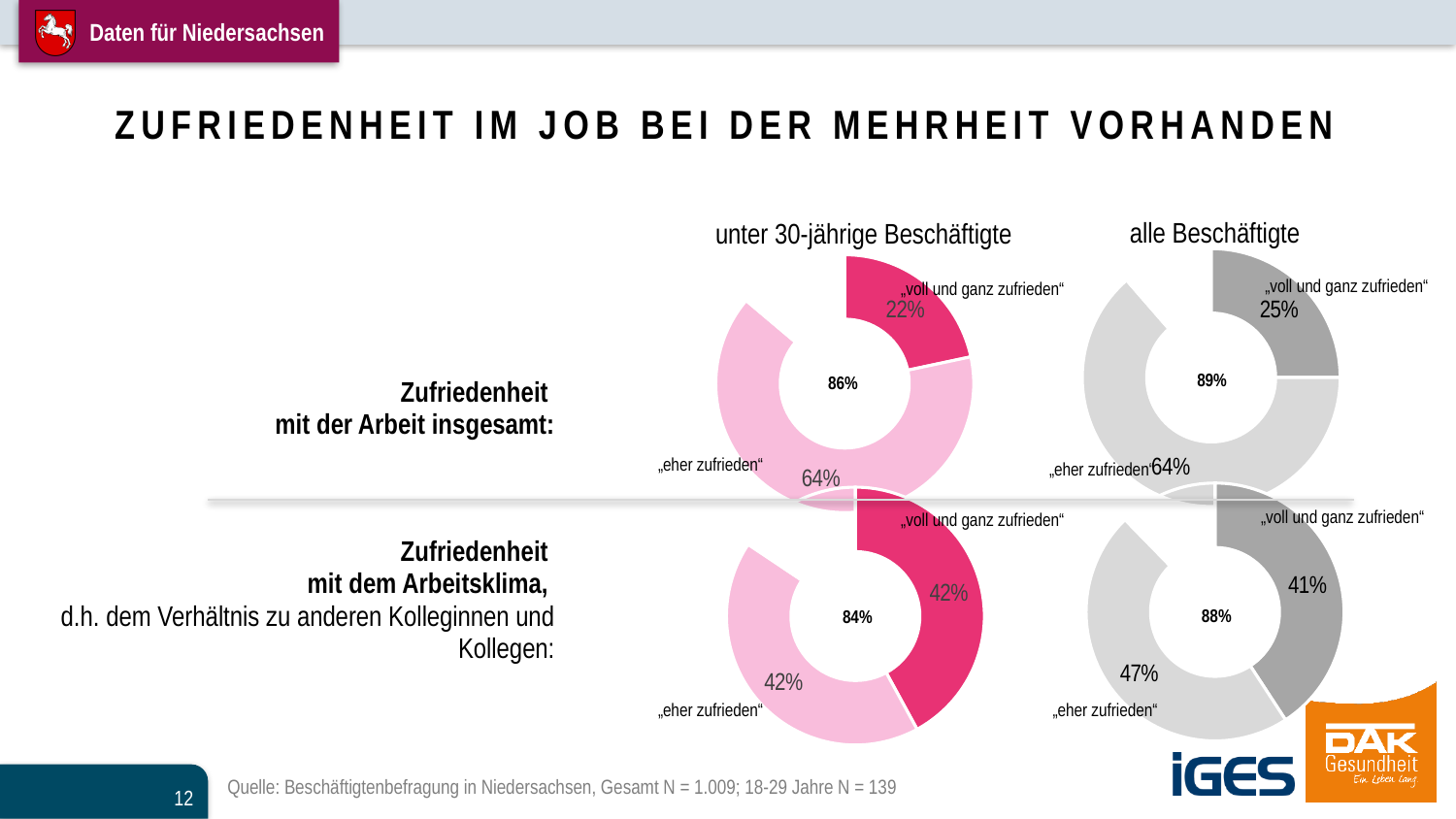
In the bottom-right donut chart (alle Beschäftigte, Arbeitsklima), what is the difference between "eher zufrieden" and "voll und ganz zufrieden"? 6% In the top-right donut chart (alle Beschäftigte, Arbeit insgesamt), what is the difference between "eher zufrieden" and "voll und ganz zufrieden"? 39% In the bottom-right donut chart (alle Beschäftigte, Zufriedenheit mit dem Arbeitsklima), what share is "eher zufrieden"? 47% In the top-right donut chart (alle Beschäftigte, Zufriedenheit mit der Arbeit insgesamt), what share is "voll und ganz zufrieden"? 25% How many donut charts are shown on the slide? 4 In the top-left donut chart (unter 30-jährige Beschäftigte, Arbeit insgesamt), which is larger: "eher zufrieden" or "voll und ganz zufrieden"? eher zufrieden What kind of chart is used on this slide? Donut (pie) chart In the top-left donut chart (unter 30-jährige Beschäftigte, Zufriedenheit mit der Arbeit insgesamt), what share is "eher zufrieden"? 64% What total percentage is shown in the centre of the bottom-left donut chart (unter 30-jährige Beschäftigte, Zufriedenheit mit dem Arbeitsklima)? 84% What total percentage is shown in the centre of the top-right donut chart (alle Beschäftigte, Zufriedenheit mit der Arbeit insgesamt)? 89% In the top-left donut chart (unter 30-jährige Beschäftigte, Zufriedenheit mit der Arbeit insgesamt), what share is "voll und ganz zufrieden"? 22% In the bottom-right donut chart (alle Beschäftigte, Zufriedenheit mit dem Arbeitsklima), what share is "voll und ganz zufrieden"? 41%